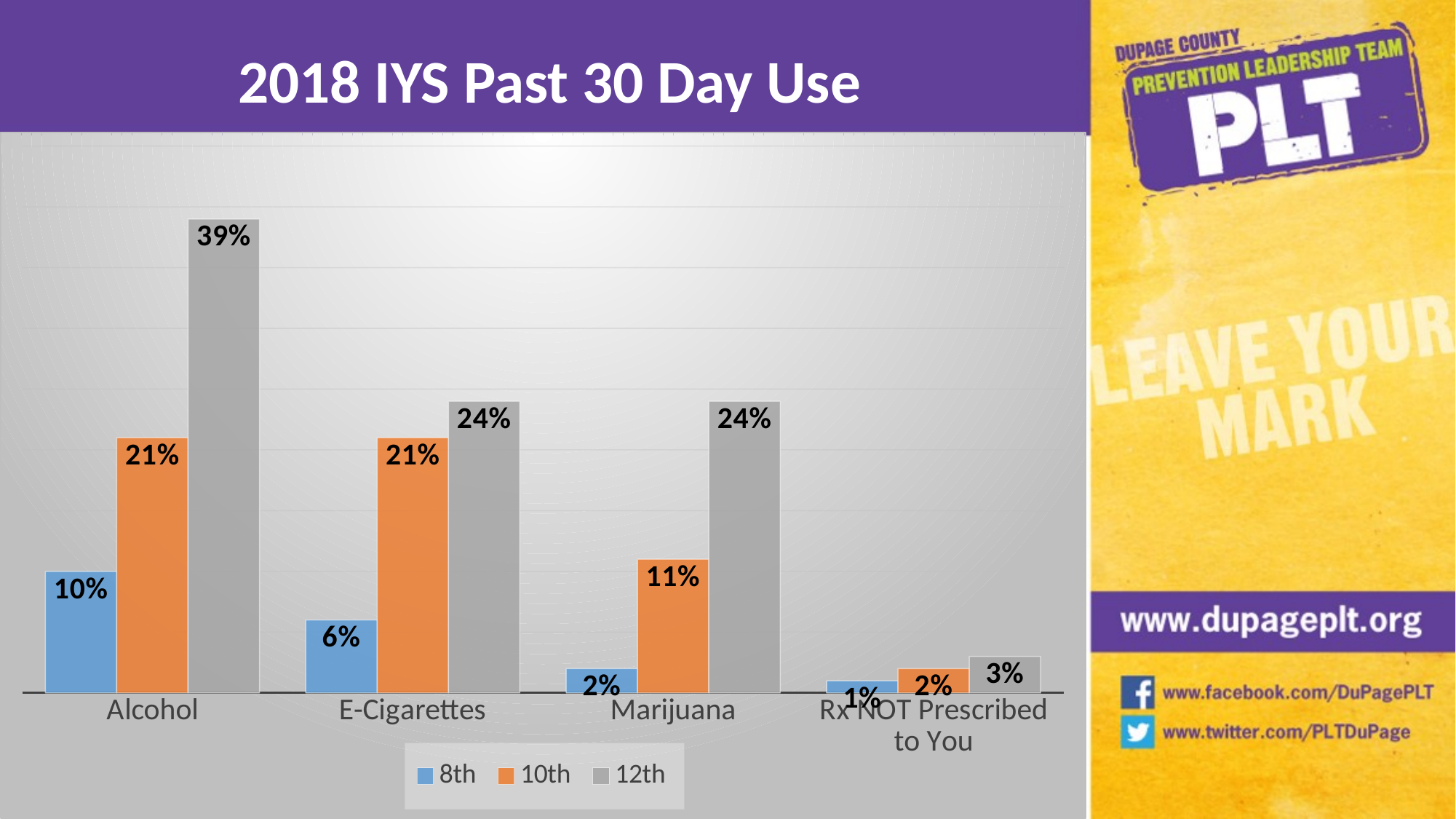
How many series does the legend list? 3 How many categories are shown on the x axis? 4 What kind of chart is shown on the slide? Bar chart What is the 12th grade value for Alcohol? 39% What is the title of the chart? 2018 IYS Past 30 Day Use What is the 10th grade value for Marijuana? 11% What is the 8th grade value for E-Cigarettes? 6% Which category has the highest 12th grade value? Alcohol What is the 12th grade value for Rx NOT Prescribed to You? 3% Which is larger, the 10th grade value for E-Cigarettes or the 10th grade value for Marijuana? E-Cigarettes What is the difference between the 12th grade and 10th grade values for Alcohol? 18% Which category has the lowest 8th grade value? Rx NOT Prescribed to You